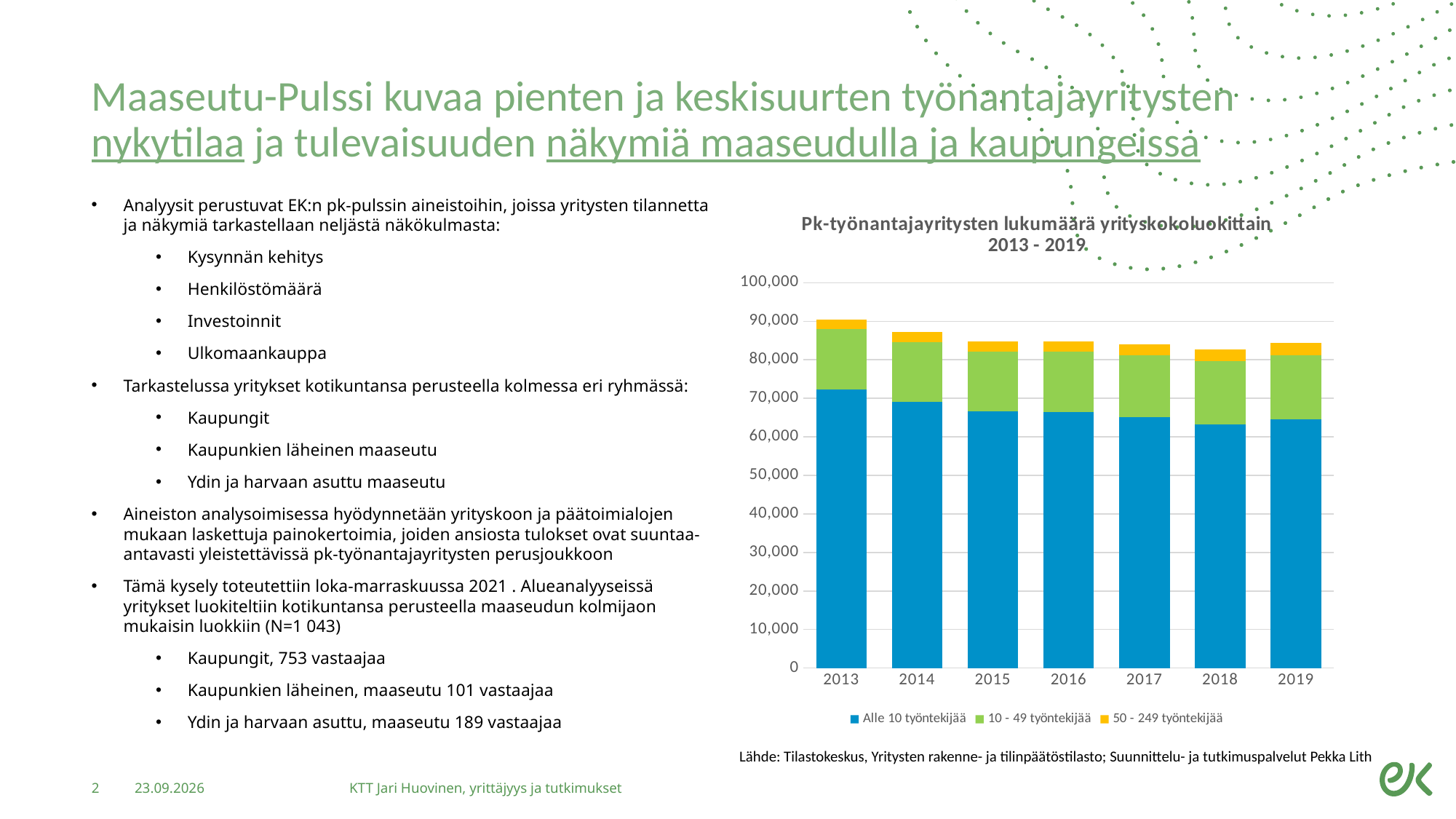
Is the value for 'Alle 10 työntekijää' in 2013 greater or less than 70,000? greater Which series is shown in blue in the chart? Alle 10 työntekijää How many years are shown on the x axis of the chart? 7 Which is larger, the 'Alle 10 työntekijää' value in 2013 or in 2019? 2013 Which year has the highest total number of companies in the chart? 2013 Does the 'Alle 10 työntekijää' series generally rise or fall from 2013 to 2018? fall What is the title of the chart? Pk-työnantajayritysten lukumäärä yrityskokoluokittain 2013 - 2019 How many series does the chart's legend list? 3 Is the value for 'Alle 10 työntekijää' in 2018 greater or less than 70,000? less What kind of chart is shown on the slide? Stacked bar chart Which year has the highest value for 'Alle 10 työntekijää'? 2013 Is the total stacked value for 2019 greater or less than 90,000? less